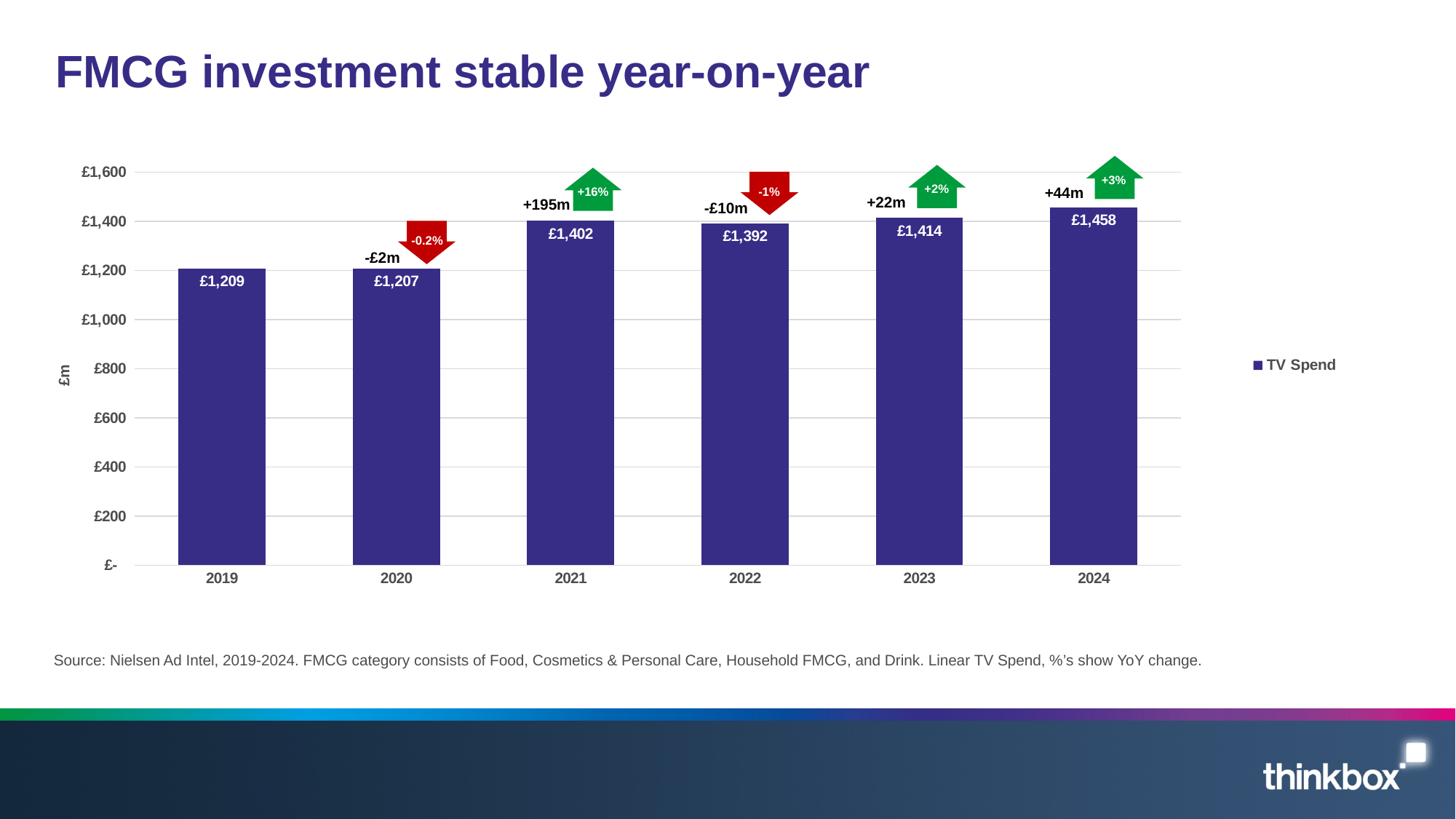
How many series does the legend list? 1 What is the year-on-year percentage change shown for 2021? +16% Is the TV Spend value for 2023 greater or less than £1,400? greater What is the TV Spend value for 2022? £1,392 Which year has the larger TV Spend, 2021 or 2022? 2021 Which year has the lowest TV Spend? 2020 Which year has the highest TV Spend? 2024 What is the TV Spend value for 2024? £1,458 What is the difference in TV Spend between 2021 and 2020? £195 How many years are shown on the x axis? 6 What is the TV Spend value for 2019? £1,209 What kind of chart is shown on the slide? Bar chart